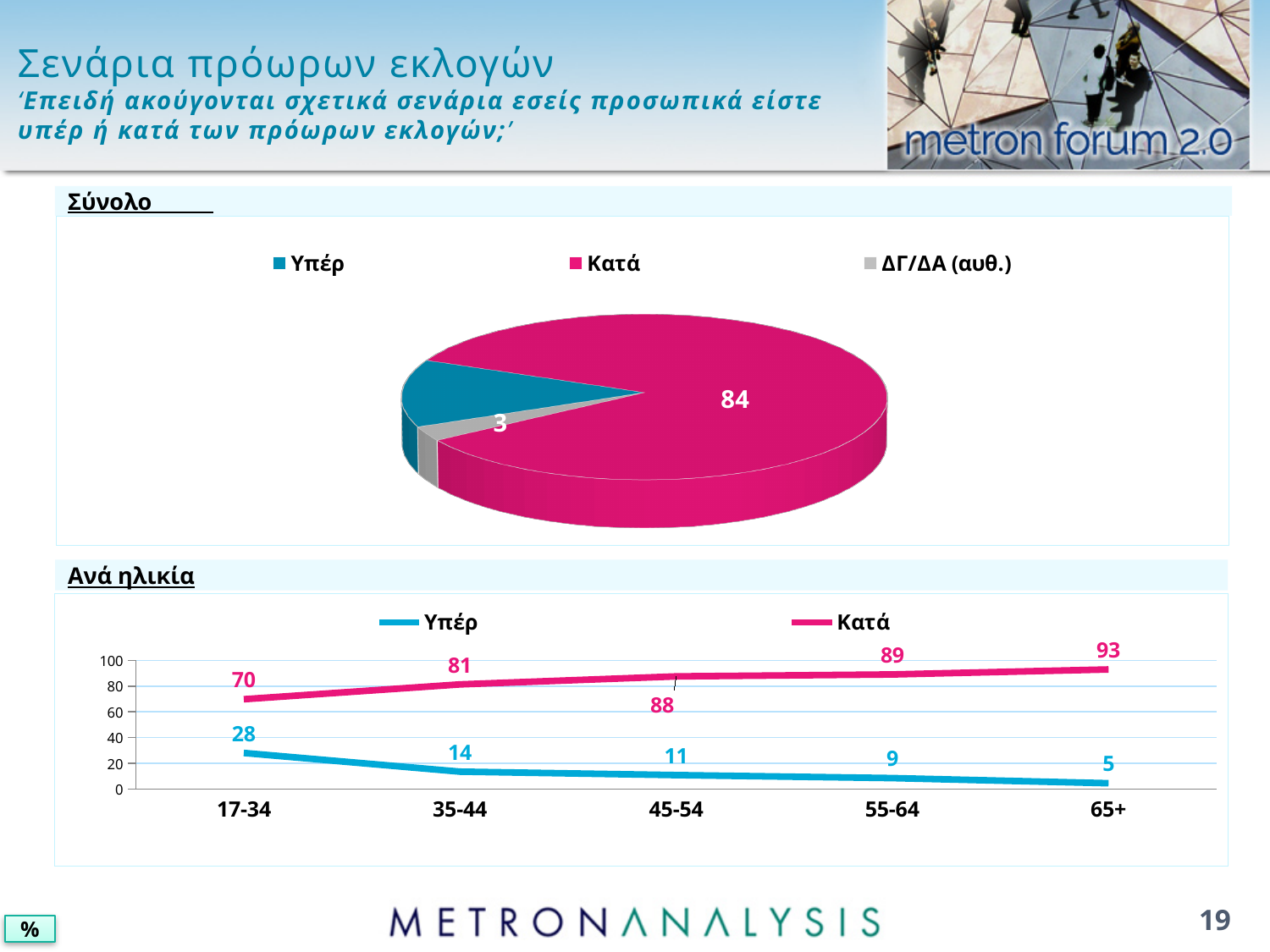
In the chart titled Ανά ηλικία, does the Υπέρ line rise or fall as age increases? fall In the pie chart titled Σύνολο, what value is shown for Κατά? 84 In the pie chart titled Σύνολο, what value is shown for ΔΓ/ΔΑ (αυθ.)? 3 In the pie chart titled Σύνολο, which category has the largest slice? Κατά In the chart titled Ανά ηλικία, how many age groups are shown on the x axis? 5 In the chart titled Ανά ηλικία, which age group has the lowest Υπέρ value? 65+ In the chart titled Ανά ηλικία, which age group has the highest Κατά value? 65+ In the chart titled Ανά ηλικία, what is the difference between the Κατά value for 65+ and the Κατά value for 17-34? 23 In the pie chart titled Σύνολο, how many categories does the legend list? 3 In the chart titled Ανά ηλικία, what is the value of Κατά for the 45-54 age group? 88 In the chart titled Ανά ηλικία, is the Υπέρ value higher for 35-44 or for 55-64? 35-44 In the chart titled Ανά ηλικία, what is the value of Υπέρ for the 17-34 age group? 28